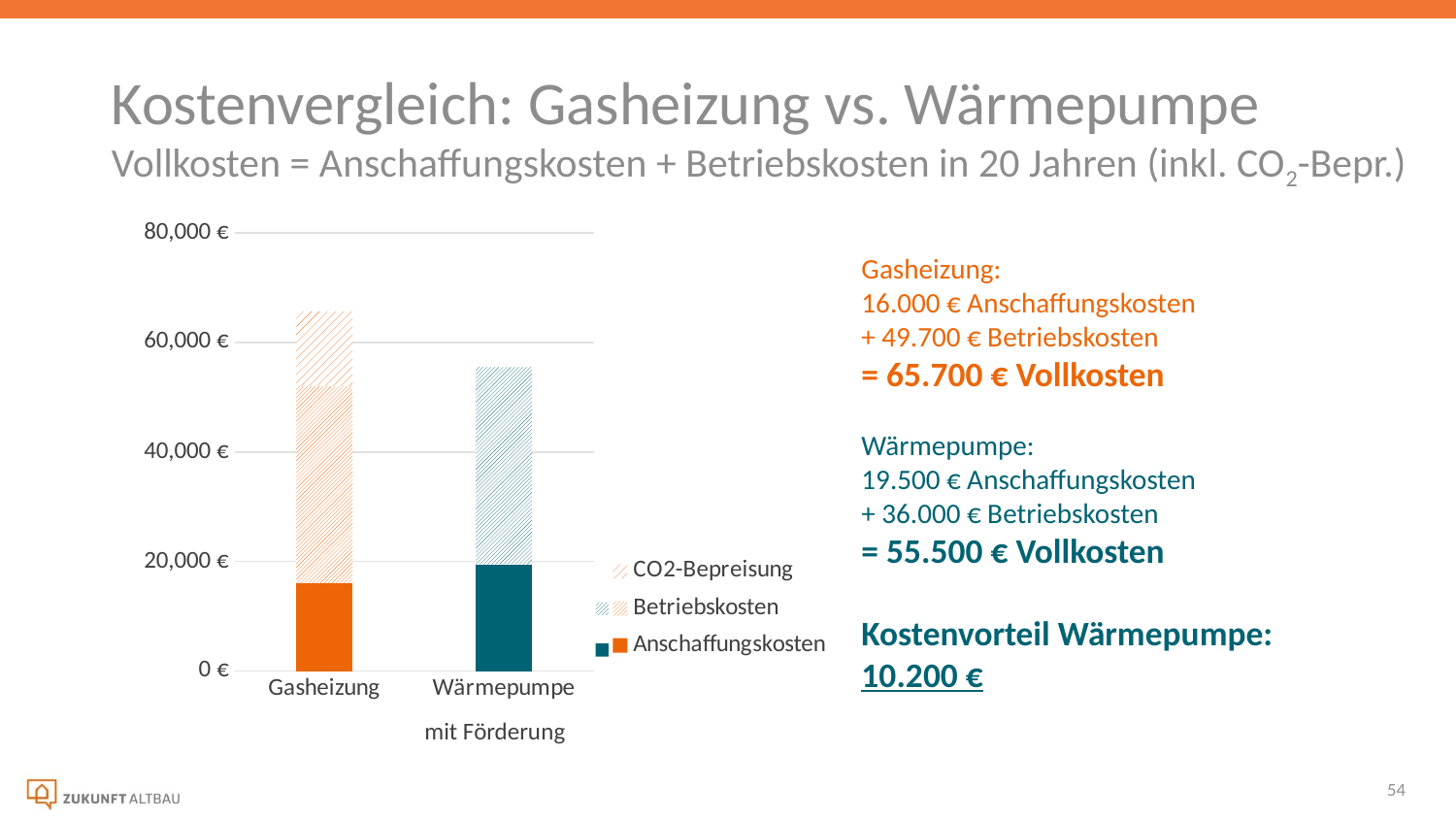
How many series does the chart legend list? 3 How many categories are shown on the x axis of the chart? 2 Which category has the larger Anschaffungskosten segment, Gasheizung or Wärmepumpe? Wärmepumpe Is the Anschaffungskosten segment for Gasheizung greater or less than 20,000 €? less Is the total bar for Gasheizung greater or less than 60,000 €? greater Which category has the lower total bar? Wärmepumpe What kind of chart is shown on the slide? stacked bar chart Which category has the higher total bar, Gasheizung or Wärmepumpe? Gasheizung What are the Vollkosten (total) for Gasheizung according to the slide? 65.700 € What are the Vollkosten (total) for Wärmepumpe according to the slide? 55.500 € What is the difference in Vollkosten between Gasheizung and Wärmepumpe? 10.200 € Is the total bar for Wärmepumpe greater or less than 60,000 €? less